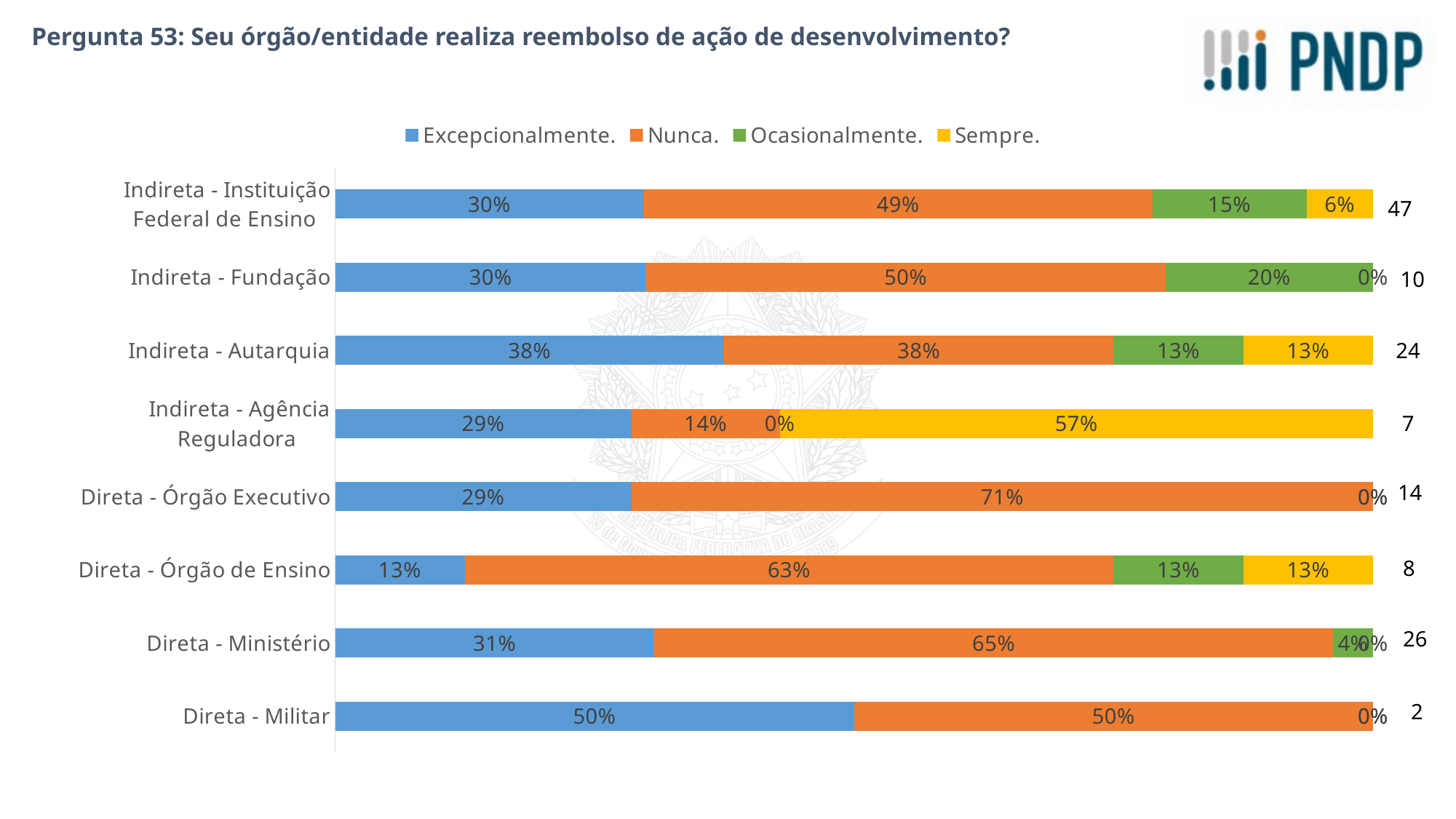
What number is printed at the right end of the bar for Indireta - Autarquia? 24 Which category has the highest percentage for Nunca? Direta - Órgão Executivo How many categories are shown on the vertical axis? 8 What percentage of Direta - Órgão Executivo answered Nunca? 71% Which has a larger Sempre percentage: Indireta - Autarquia or Indireta - Instituição Federal de Ensino? Indireta - Autarquia For Direta - Ministério, what is the difference between the Nunca and Excepcionalmente percentages? 34 percentage points What percentage of Indireta - Agência Reguladora answered Sempre? 57% What percentage of Indireta - Fundação answered Ocasionalmente? 20% What is the title of the slide? Pergunta 53: Seu órgão/entidade realiza reembolso de ação de desenvolvimento? Which category has the lowest percentage for Excepcionalmente? Direta - Órgão de Ensino How many series does the legend list? 4 What kind of chart is shown on the slide? Stacked bar chart